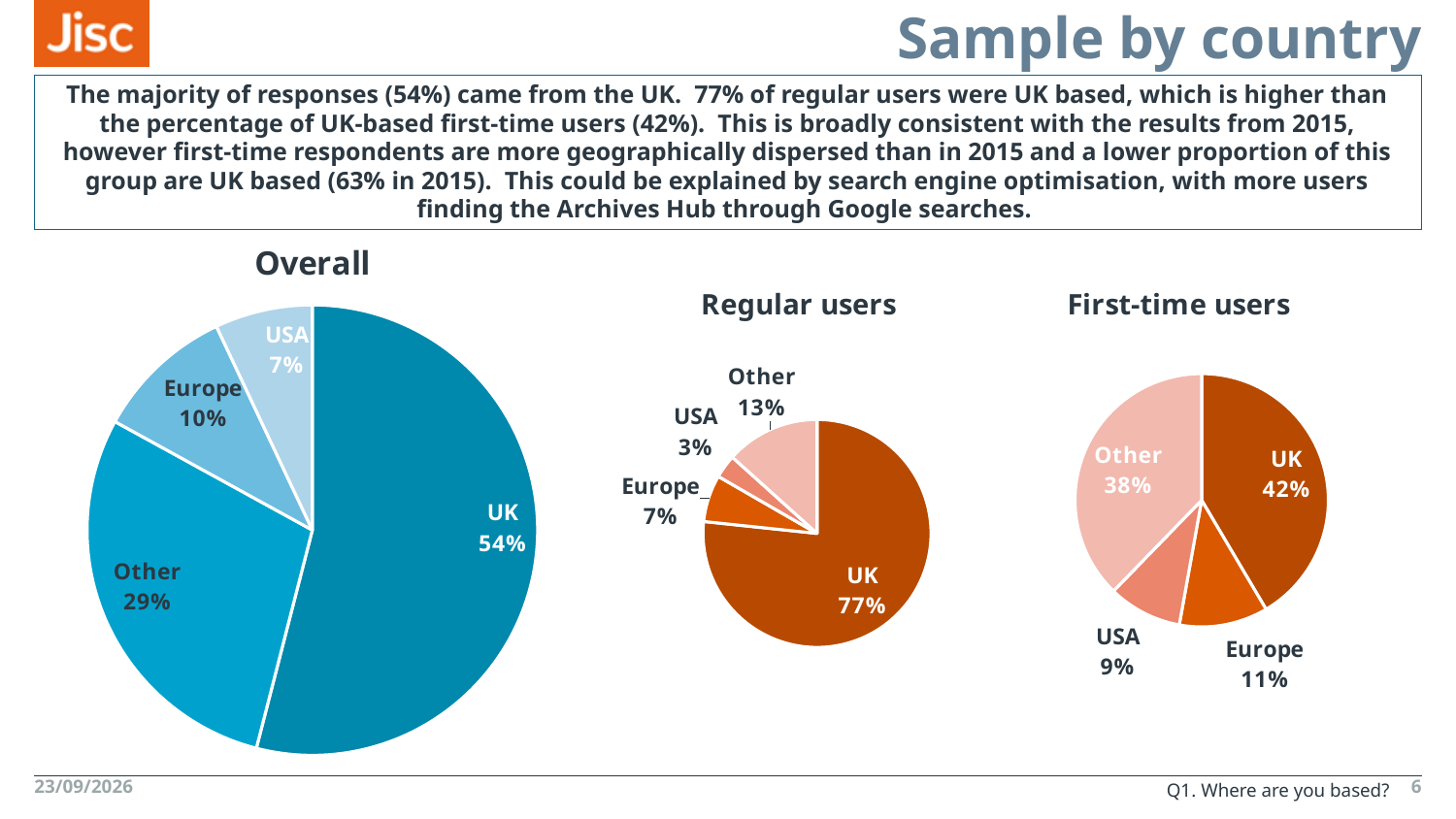
In the 'Overall' pie chart, which category has the smallest slice? USA In the 'First-time users' pie chart, what percentage is shown for Other? 38% In the 'Overall' pie chart, what share of responses came from Europe? 10% In the 'First-time users' pie chart, which category has the smallest slice? USA How many categories are shown in the 'Overall' pie chart? 4 What is the difference between the UK share in the 'Regular users' chart and the UK share in the 'First-time users' chart? 35% How many pie charts are shown on the slide? 3 In the 'Regular users' pie chart, what percentage is shown for the USA? 3% In the 'Overall' pie chart, what share of responses came from the UK? 54% What type of chart is the 'Regular users' chart? Pie chart In the 'Regular users' pie chart, which category has the largest slice? UK In the 'First-time users' pie chart, which is larger: the Europe slice or the USA slice? Europe